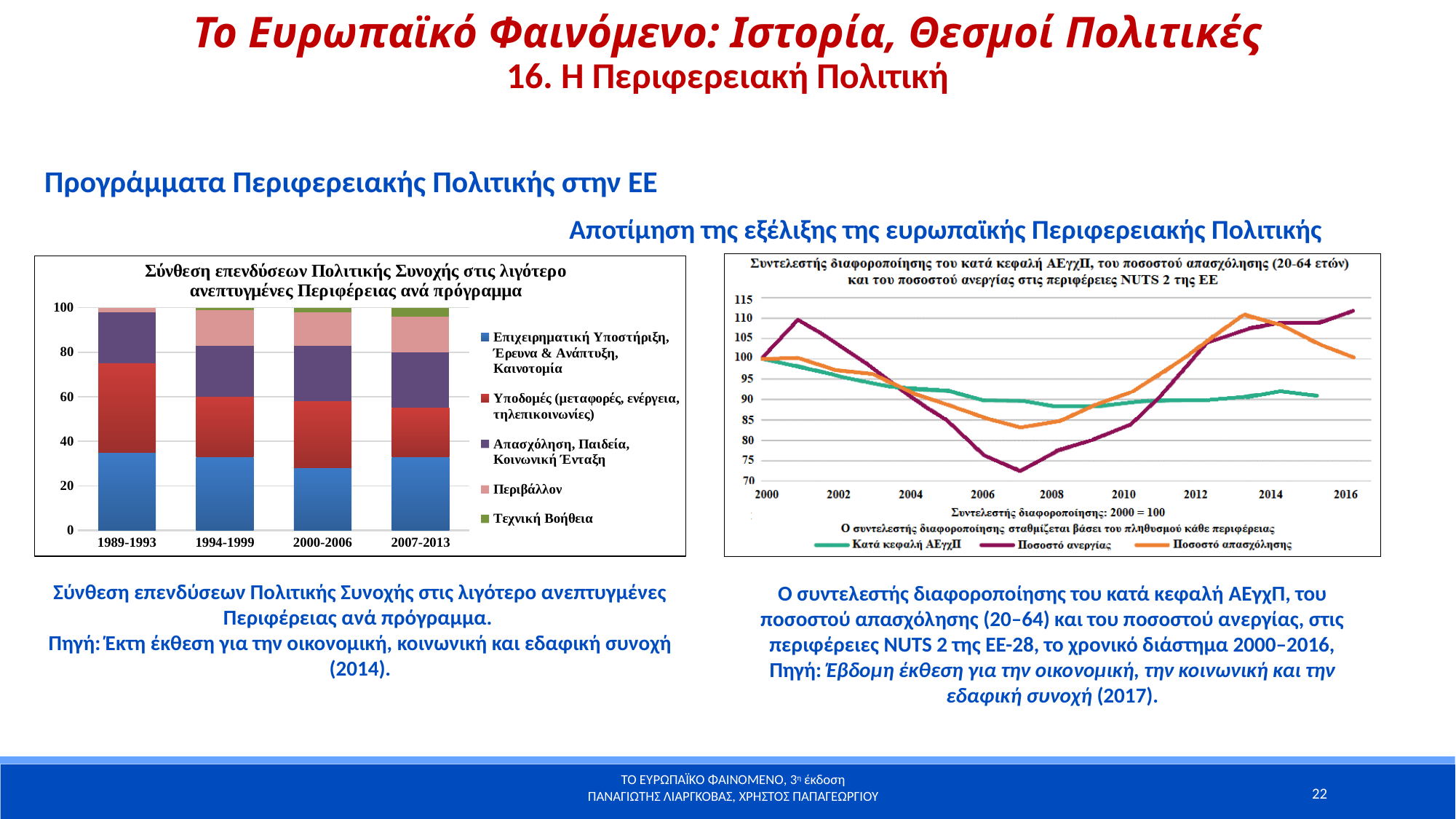
How many programme periods (categories) are shown on the x axis of the left bar chart? 4 In the right line chart, is the value for Ποσοστό ανεργίας in 2007 greater or less than 75? less What kind of chart is the left chart titled «Σύνθεση επενδύσεων Πολιτικής Συνοχής στις λιγότερο ανεπτυγμένες Περιφέρειας ανά πρόγραμμα»? Stacked bar chart In the left bar chart, is the value for Επιχειρηματική Υποστήριξη, Έρευνα & Ανάπτυξη, Καινοτομία in 2000-2006 greater or less than 40? less In the left bar chart, is the value for Επιχειρηματική Υποστήριξη, Έρευνα & Ανάπτυξη, Καινοτομία in 1989-1993 greater or less than 20? greater How many series does the legend of the left bar chart list? 5 In the right line chart, what is the value of Κατά κεφαλή ΑΕγχΠ in 2000? 100 In the right line chart, which is larger in 2016: Ποσοστό ανεργίας or Ποσοστό απασχόλησης? Ποσοστό ανεργίας What kind of chart is the right chart about the Συντελεστής διαφοροποίησης in NUTS 2 regions? Line chart In the left bar chart, which series is shown in green? Τεχνική Βοήθεια How many series does the legend of the right line chart list? 3 In the right line chart, in which year does Ποσοστό ανεργίας reach its lowest value? 2007